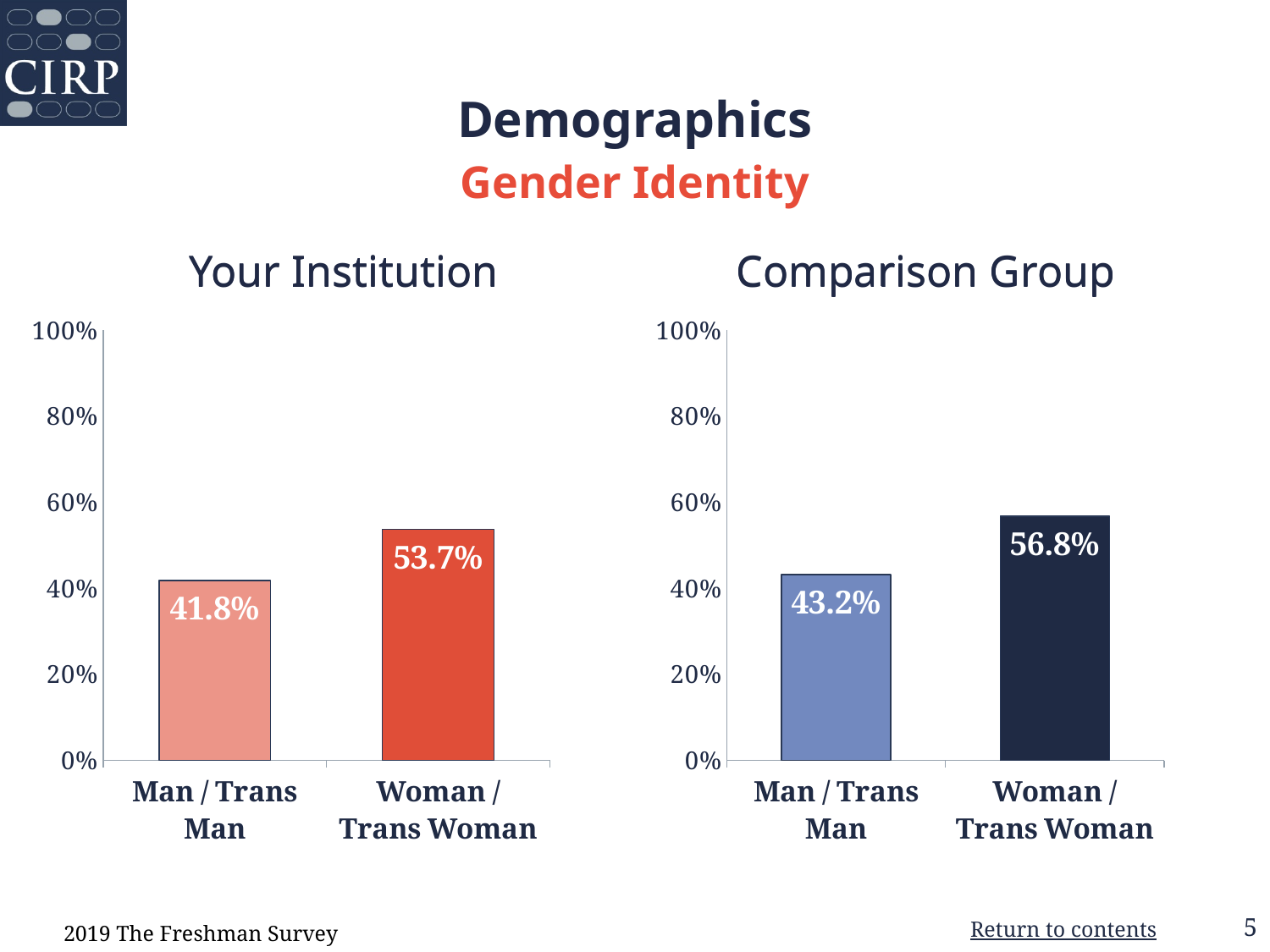
In the Your Institution chart, which category has the highest value? Woman / Trans Woman In the Your Institution chart, what is the value for Woman / Trans Woman? 53.7% In the Comparison Group chart, which category has the lowest value? Man / Trans Man In the Comparison Group chart, what is the value for Woman / Trans Woman? 56.8% In the Comparison Group chart, what is the value for Man / Trans Man? 43.2% In the Your Institution chart, what is the difference between the Woman / Trans Woman and Man / Trans Man values? 11.9% In the Comparison Group chart, is the value for Man / Trans Man greater or less than 60%? less What kind of chart is the Comparison Group chart? Bar chart In the Comparison Group chart, what is the difference between the Woman / Trans Woman and Man / Trans Man values? 13.6% In the Your Institution chart, what is the value for Man / Trans Man? 41.8% How many categories are shown in the Your Institution chart? 2 Is the Man / Trans Man value larger in the Your Institution chart or the Comparison Group chart? Comparison Group